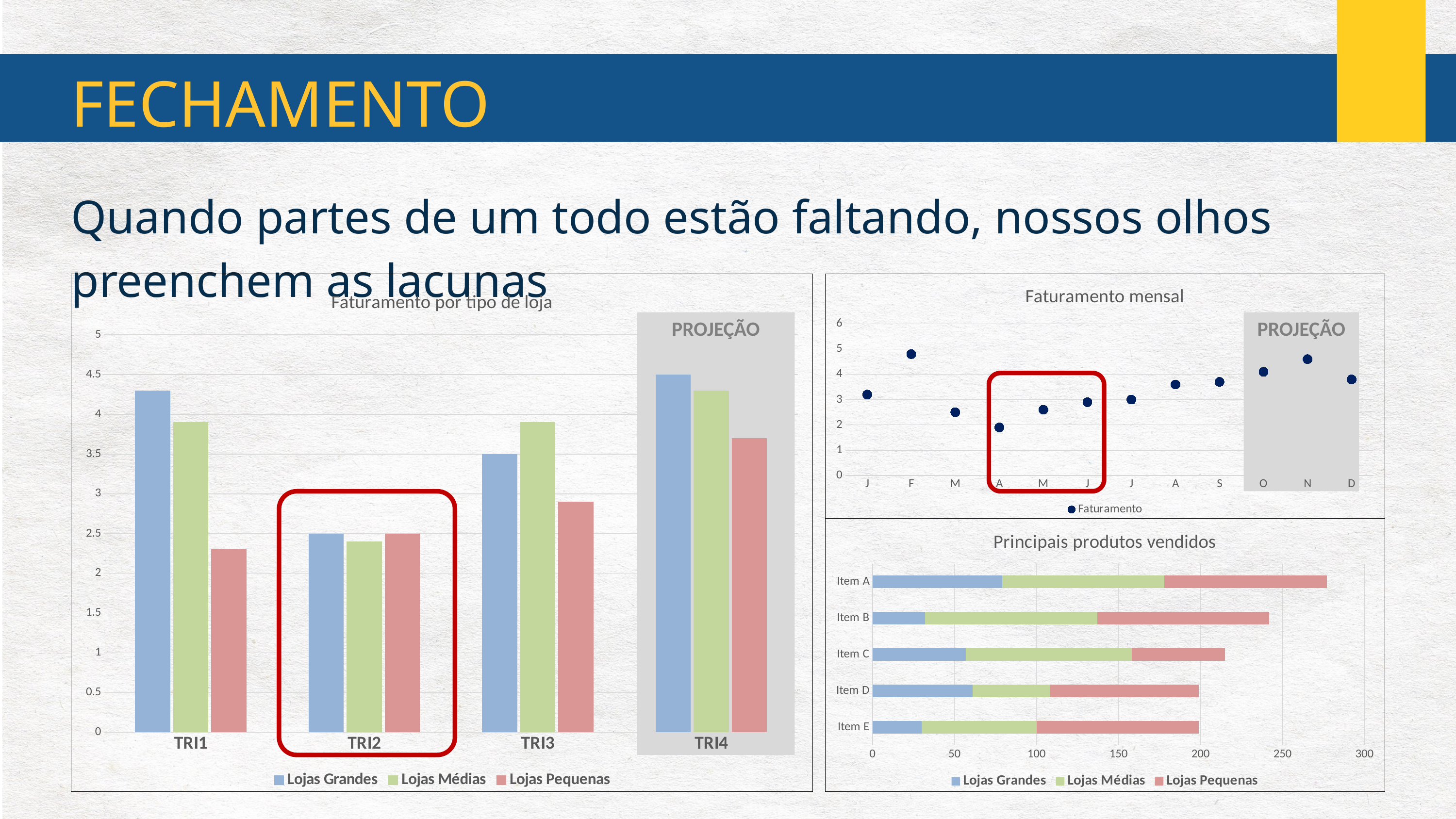
In 'Principais produtos vendidos', which item has the longest total bar? Item A In 'Faturamento por tipo de loja', what is the value for Lojas Grandes in TRI2? 2.5 In 'Faturamento por tipo de loja', how many series does the legend list? 3 What kind of chart is 'Faturamento por tipo de loja'? bar chart In 'Faturamento por tipo de loja', how many quarters are shown on the x axis? 4 In 'Faturamento mensal', how many data points are plotted? 12 In 'Faturamento mensal', is the value for F greater or less than 4? greater In 'Faturamento por tipo de loja', which quarter is marked as PROJEÇÃO? TRI4 In 'Faturamento por tipo de loja', is the value for Lojas Pequenas in TRI4 greater or less than 4? less In 'Faturamento mensal', which month has the lowest value? A (April) In 'Faturamento por tipo de loja', which is larger in TRI3: Lojas Médias or Lojas Pequenas? Lojas Médias In 'Faturamento por tipo de loja', which store type has the highest value in TRI1? Lojas Grandes